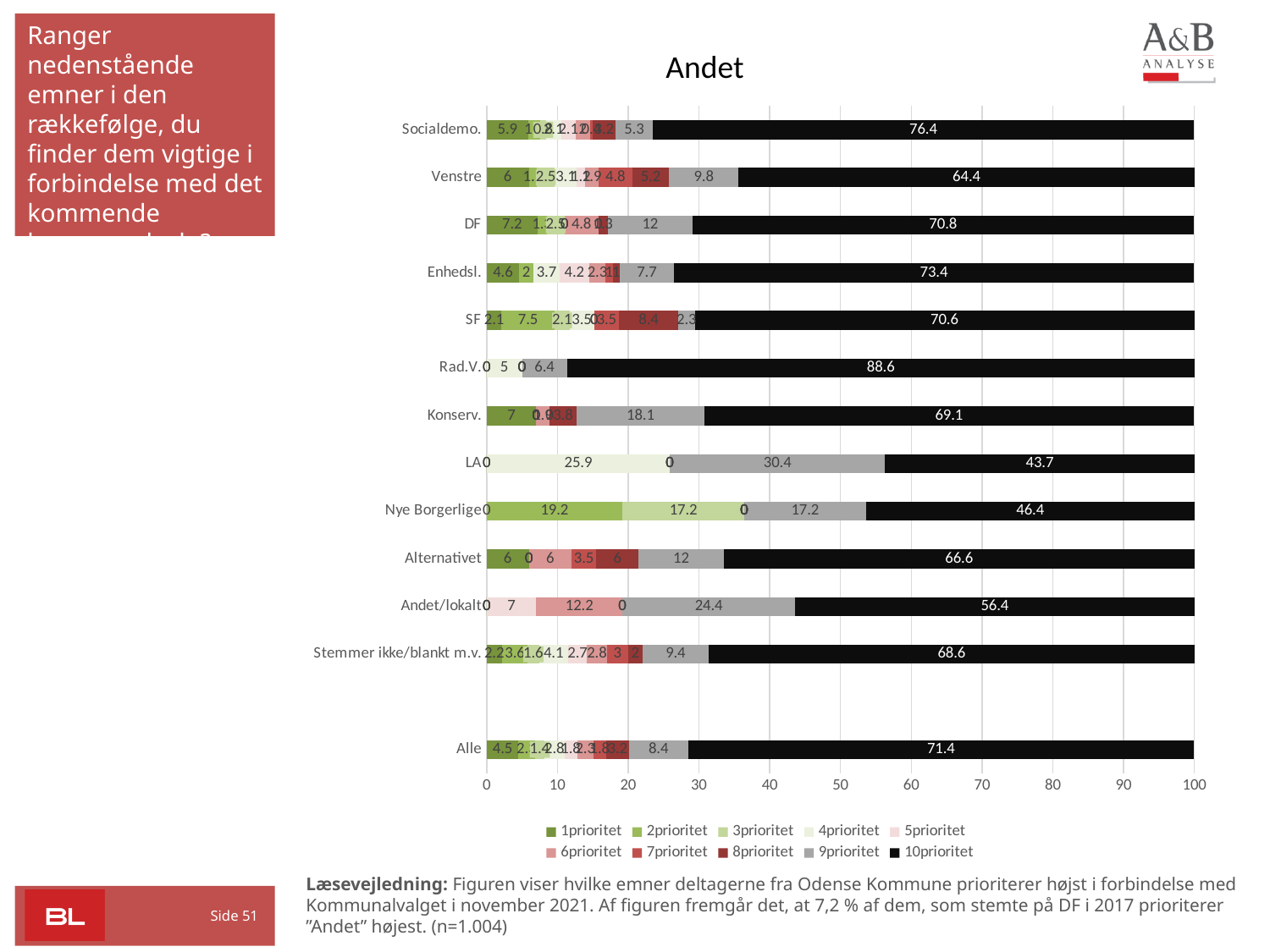
What is the title of the chart? Andet What type of chart is shown on the slide? stacked bar chart What is the 10prioritet value for Socialdemo.? 76.4 What is the difference between the 10prioritet values for Socialdemo. and Venstre? 12 Which has a larger 9prioritet value, Konserv. or Andet/lokalt? Andet/lokalt What is the 1prioritet value for DF? 7.2 Which category has the lowest 10prioritet value? LA How many categories are plotted on the y axis? 13 How many series does the legend list? 10 What is the 9prioritet value for LA? 30.4 What is the 10prioritet value for Rad.V.? 88.6 Which category has the highest 10prioritet value? Rad.V.